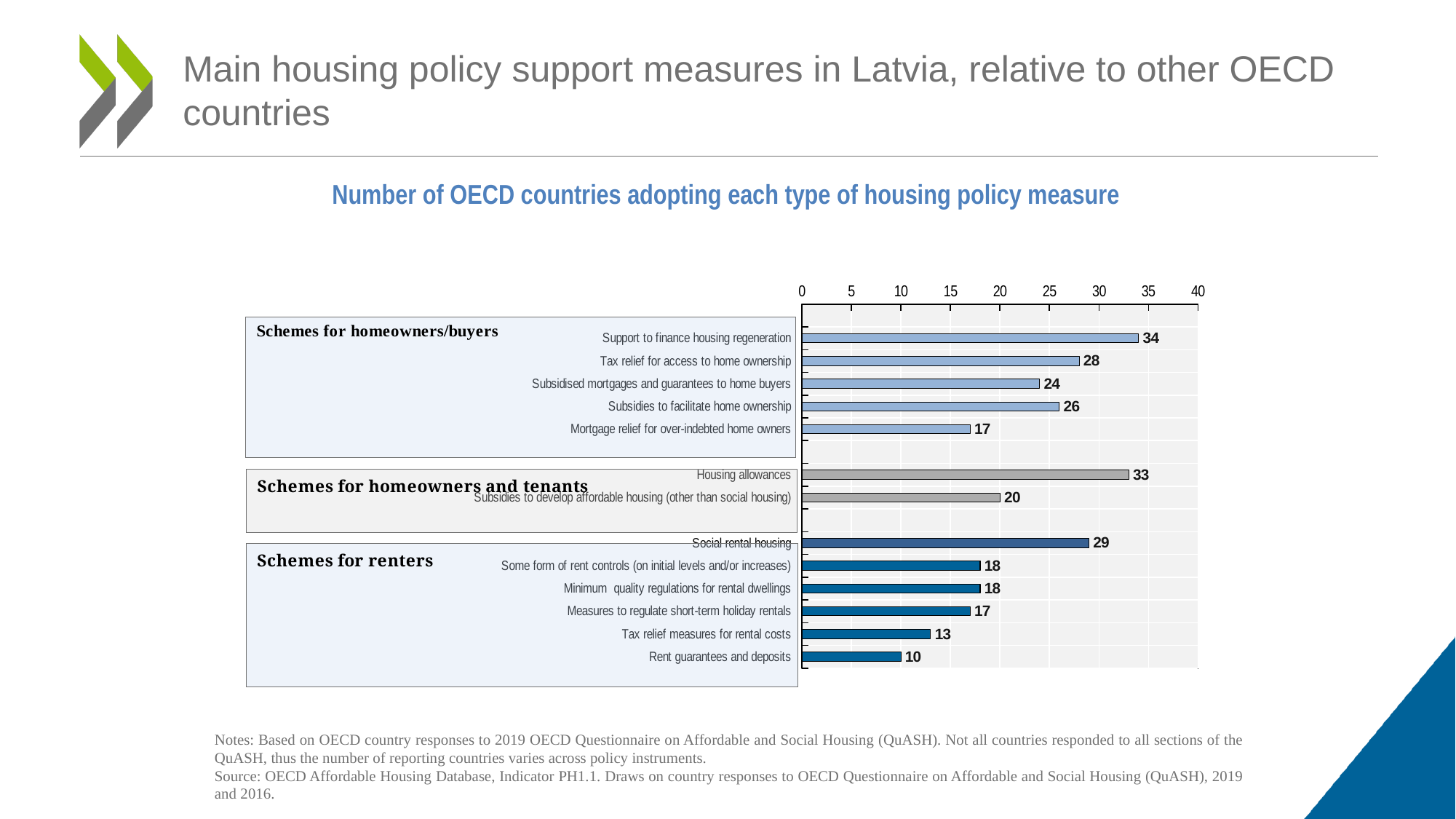
What is the value for social rental housing? 29 How many countries have rent guarantees and deposits? 10 Which has a higher value: subsidies to facilitate home ownership or mortgage relief for over-indebted home owners? Subsidies to facilitate home ownership Which housing policy measure is adopted by the most OECD countries? Support to finance housing regeneration How many OECD countries adopt support to finance housing regeneration? 34 How many measures are listed under Schemes for renters? 6 What is the difference between the number of countries with tax relief for access to home ownership and the number with subsidised mortgages and guarantees to home buyers? 4 What is the title of the chart? Number of OECD countries adopting each type of housing policy measure Which housing policy measure is adopted by the fewest OECD countries? Rent guarantees and deposits What kind of chart is shown on the slide? Bar chart What is the value for housing allowances? 33 How many housing policy measures are plotted in the chart? 13